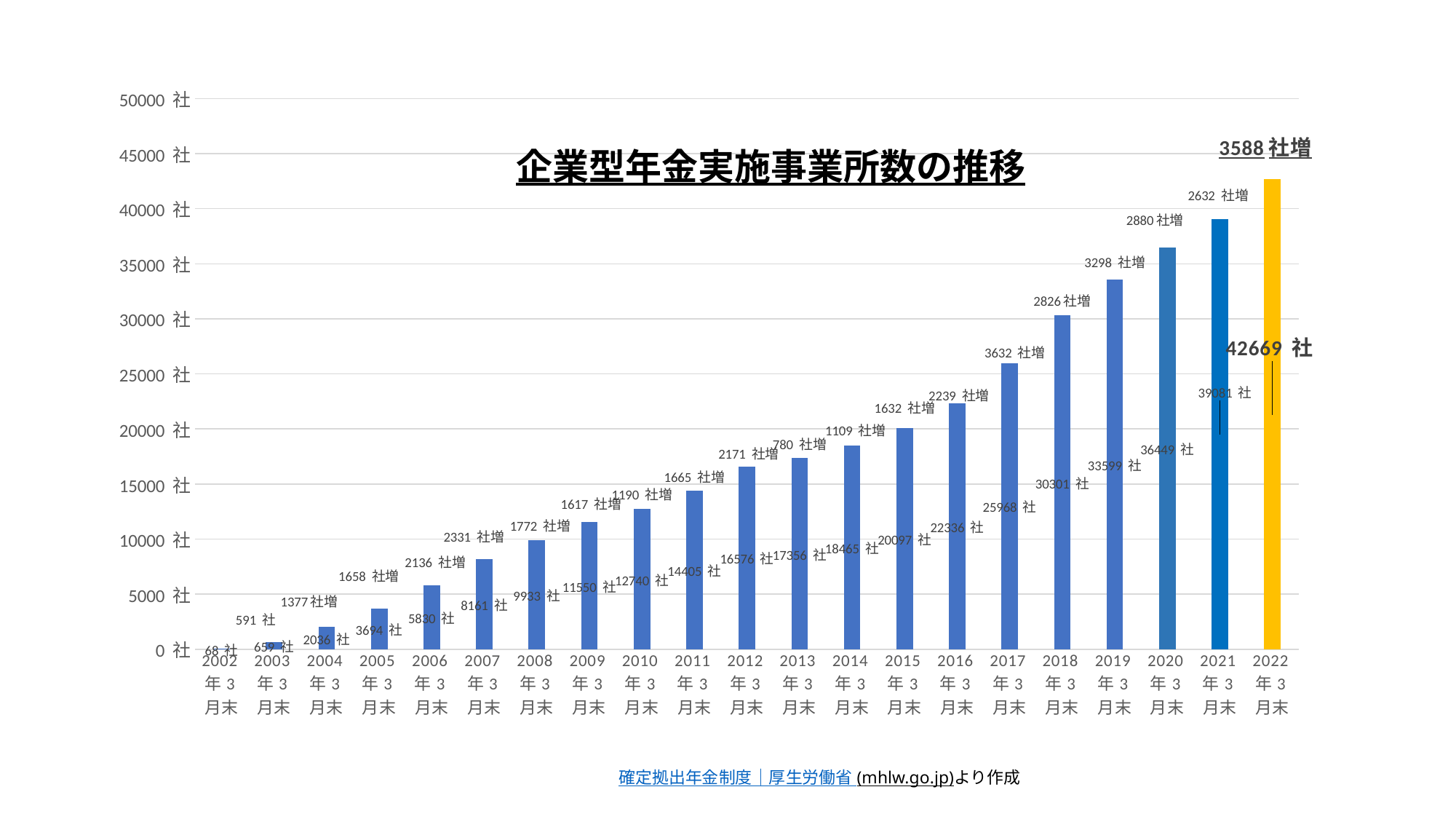
Which is larger, the value for 2010年3月末 or the value for 2011年3月末? 2011年3月末 What kind of chart is this? bar chart What is the difference between the values for 2022年3月末 and 2021年3月末? 3588 社 What is the difference between the values for 2017年3月末 and 2016年3月末? 3632 社 What is the value for 2002年3月末? 68 社 What is the value for 2022年3月末? 42669 社 What is the value for 2012年3月末? 16576 社 Which year has the highest value? 2022年3月末 How many bars are shown in the chart? 21 Do the values rise or fall from 2002 to 2022? rise Is the value for 2018年3月末 greater or less than 30000? greater Which year has the lowest value? 2002年3月末